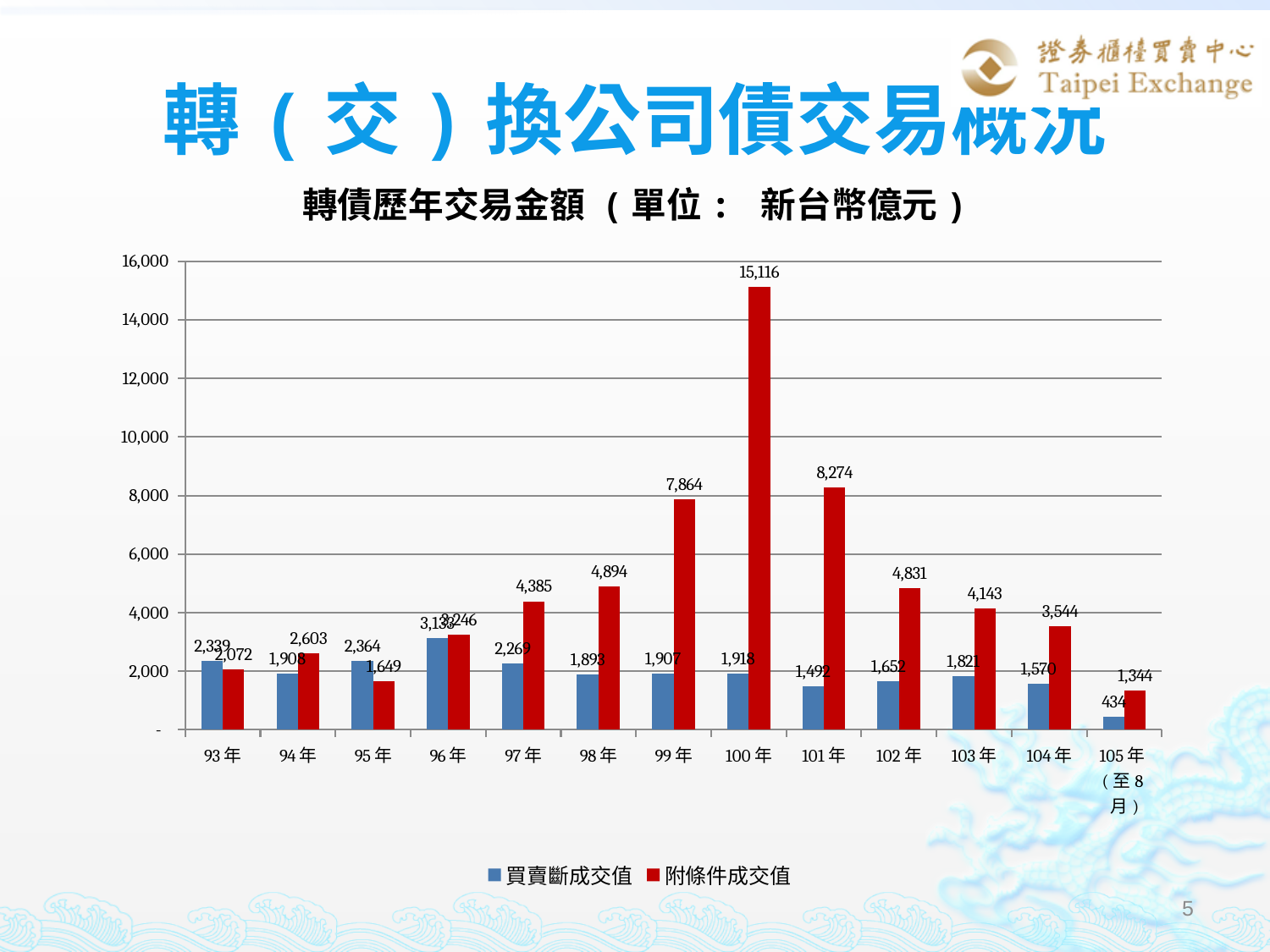
What is the difference between 附條件成交值 and 買賣斷成交值 for 101 年? 6,782 How many series does the legend list? 2 Is the 附條件成交值 for 99 年 greater or less than 6,000? greater What kind of chart is shown on the slide? bar chart What is the value of 附條件成交值 for 100 年? 15,116 What is the value of 附條件成交值 for 104 年? 3,544 What is the value of 買賣斷成交值 for 93 年? 2,339 For 95 年, which is larger: 買賣斷成交值 or 附條件成交值? 買賣斷成交值 Which colour represents 附條件成交值 in the chart? red How many years are shown on the x axis? 13 Which year has the lowest 買賣斷成交值? 105 年（至 8 月） Which year has the highest 附條件成交值? 100 年